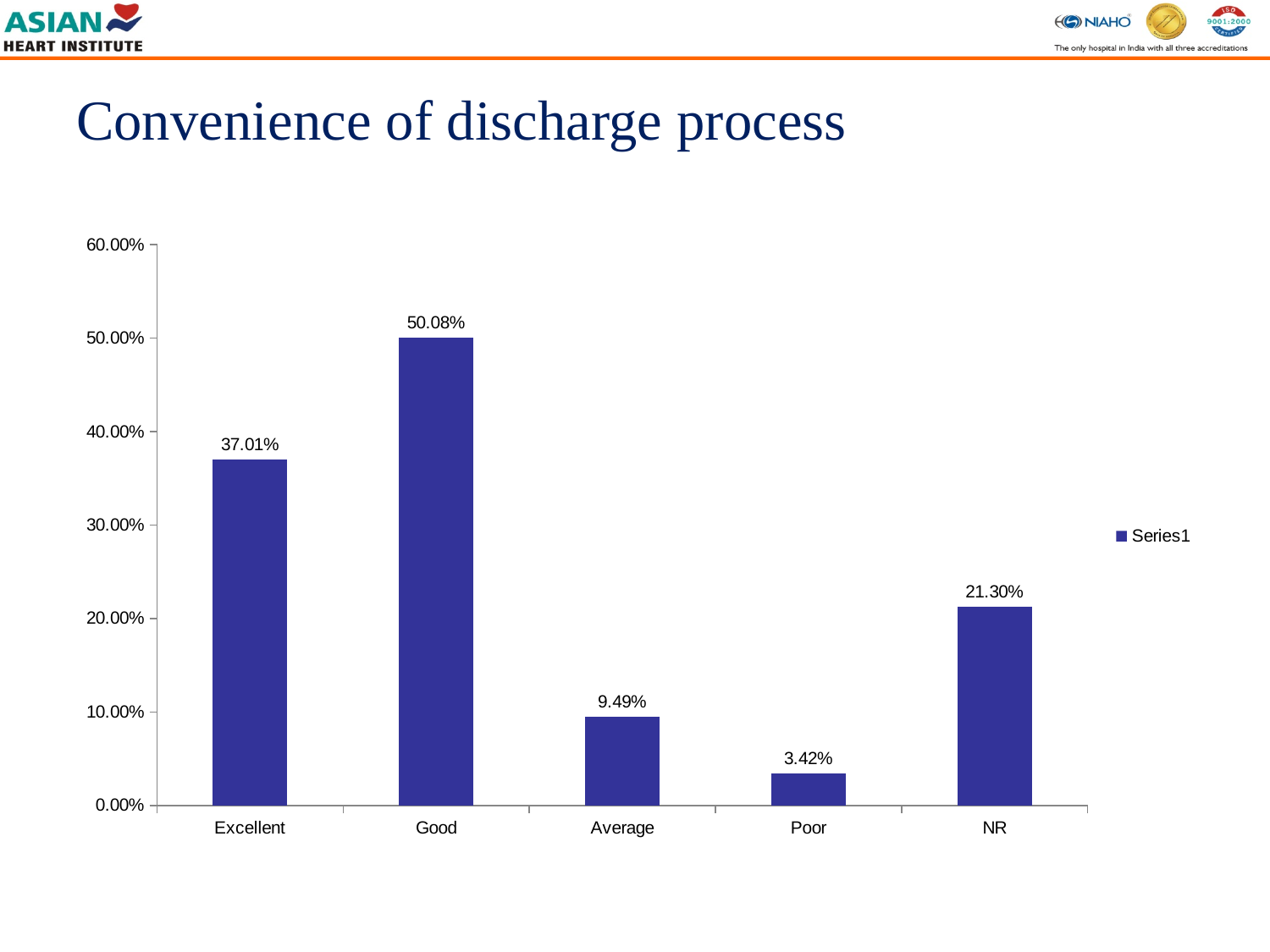
What is the title of the slide? Convenience of discharge process Is the value for Average greater or less than 10.00%? less What is the value for Good? 50.08% Which category has the lowest value? Poor What is the difference between the values for NR and Average? 11.81% How many categories are shown on the x axis? 5 What kind of chart is shown on the slide? bar chart What is the value for NR? 21.30% What is the difference between the values for Good and Excellent? 13.07% What is the value for Poor? 3.42% Which category has the highest value? Good Which is larger, the value for Excellent or the value for NR? Excellent